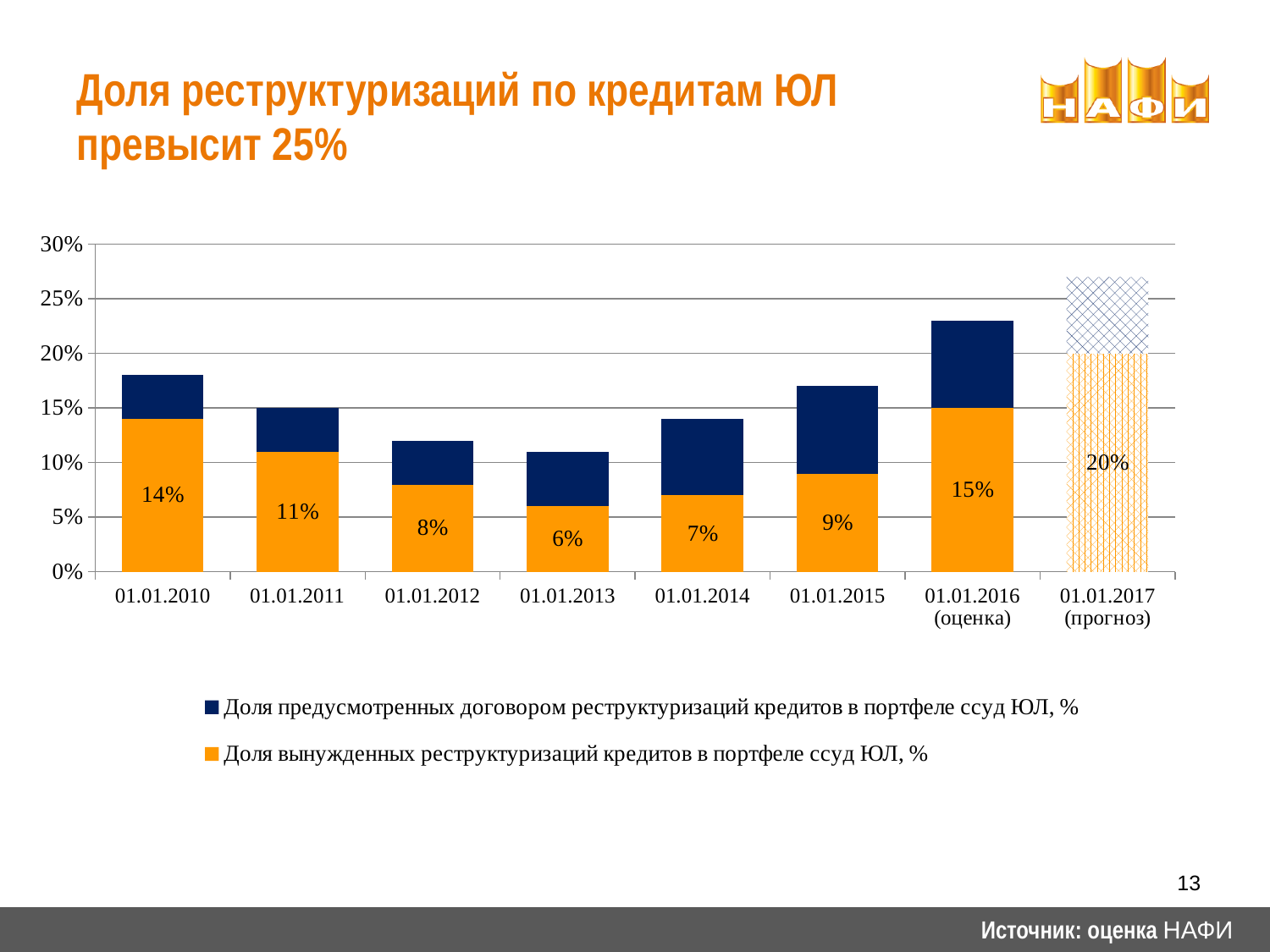
What kind of chart is shown on the slide? Stacked bar chart What is the value of the orange series (Доля вынужденных реструктуризаций) for 01.01.2017 (прогноз)? 20% Which is larger for the orange series: the value for 01.01.2011 or the value for 01.01.2014? 01.01.2011 What is the difference between the orange series values for 01.01.2016 (оценка) and 01.01.2015? 6% How many dates (categories) are shown on the x axis? 8 What is the value of the orange series (Доля вынужденных реструктуризаций) for 01.01.2013? 6% Is the total height of the stacked bar for 01.01.2013 greater or less than 15%? less What is the value of the orange series (Доля вынужденных реструктуризаций) for 01.01.2010? 14% Which date has the highest labelled value for the orange series (Доля вынужденных реструктуризаций)? 01.01.2017 (прогноз) How many series does the legend list? 2 Which date has the lowest labelled value for the orange series (Доля вынужденных реструктуризаций)? 01.01.2013 Is the total height of the stacked bar for 01.01.2017 (прогноз) greater or less than 25%? greater